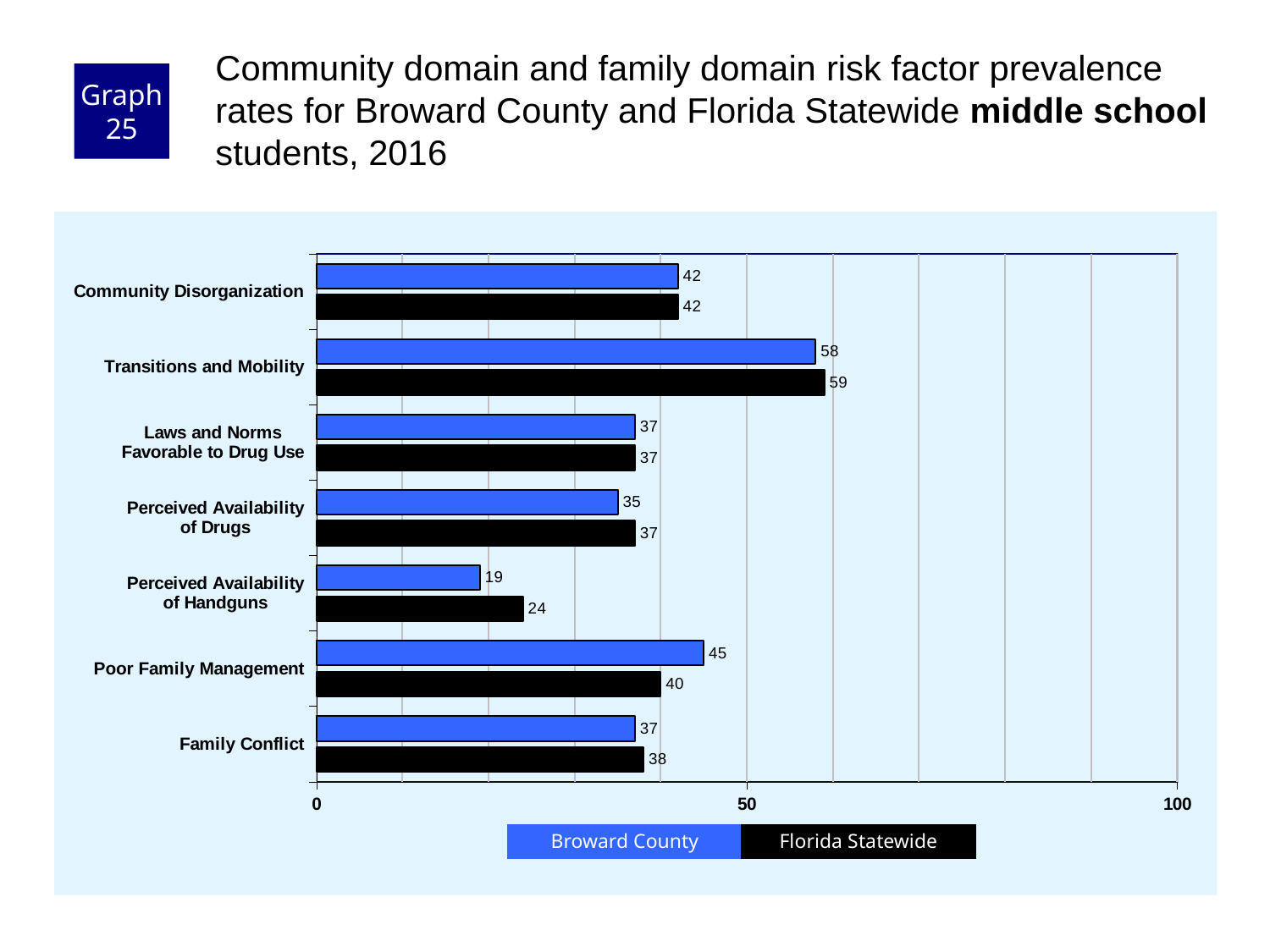
Which category has the highest Broward County value? Transitions and Mobility How many series does the legend list? 2 What kind of chart is shown on the slide? bar chart Is the Florida Statewide value for Transitions and Mobility greater or less than 50? greater What is the Broward County value for Transitions and Mobility? 58 What is the Broward County value for Poor Family Management? 45 What is the difference between the Florida Statewide and Broward County values for Perceived Availability of Handguns? 5 Which colour represents Florida Statewide in the legend? black What is the Florida Statewide value for Perceived Availability of Handguns? 24 For Poor Family Management, which is larger: the Broward County value or the Florida Statewide value? Broward County How many risk factor categories are shown on the chart? 7 Which category has the lowest Florida Statewide value? Perceived Availability of Handguns